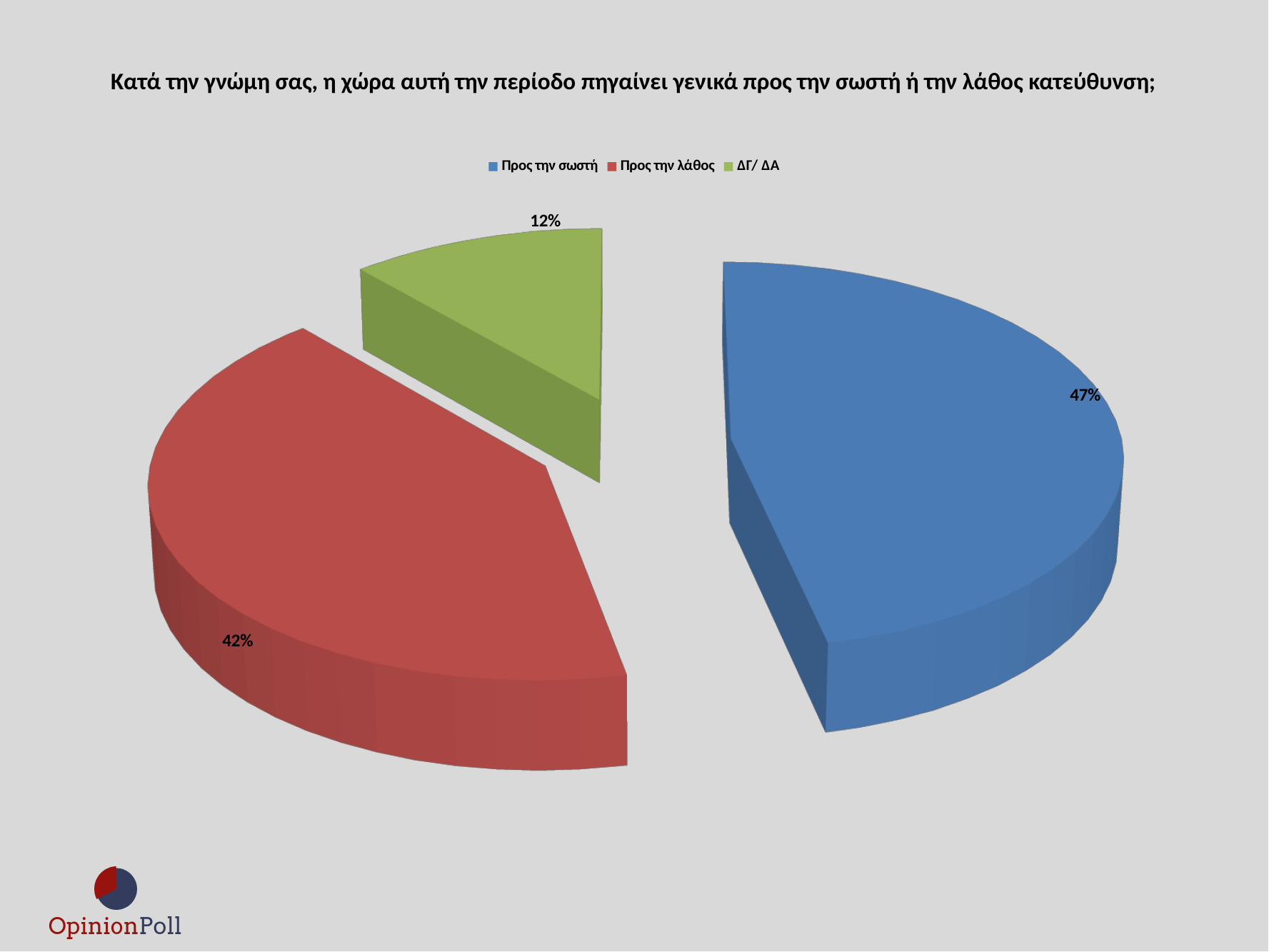
What kind of chart is shown on the slide? Pie chart Which is larger, the share for 'Προς την σωστή' or the share for 'ΔΓ/ ΔΑ'? Προς την σωστή What percentage of respondents answered 'ΔΓ/ ΔΑ'? 12% Which response has the smallest share of the pie? ΔΓ/ ΔΑ What percentage of respondents answered 'Προς την σωστή'? 47% What is the difference in percentage points between 'Προς την σωστή' and 'Προς την λάθος'? 5 How many entries does the legend list? 3 Which response has the largest share of the pie? Προς την σωστή What is the difference in percentage points between 'Προς την λάθος' and 'ΔΓ/ ΔΑ'? 30 How many slices does the pie chart have? 3 What percentage of respondents answered 'Προς την λάθος'? 42% What colour is the slice for 'Προς την λάθος'? Red